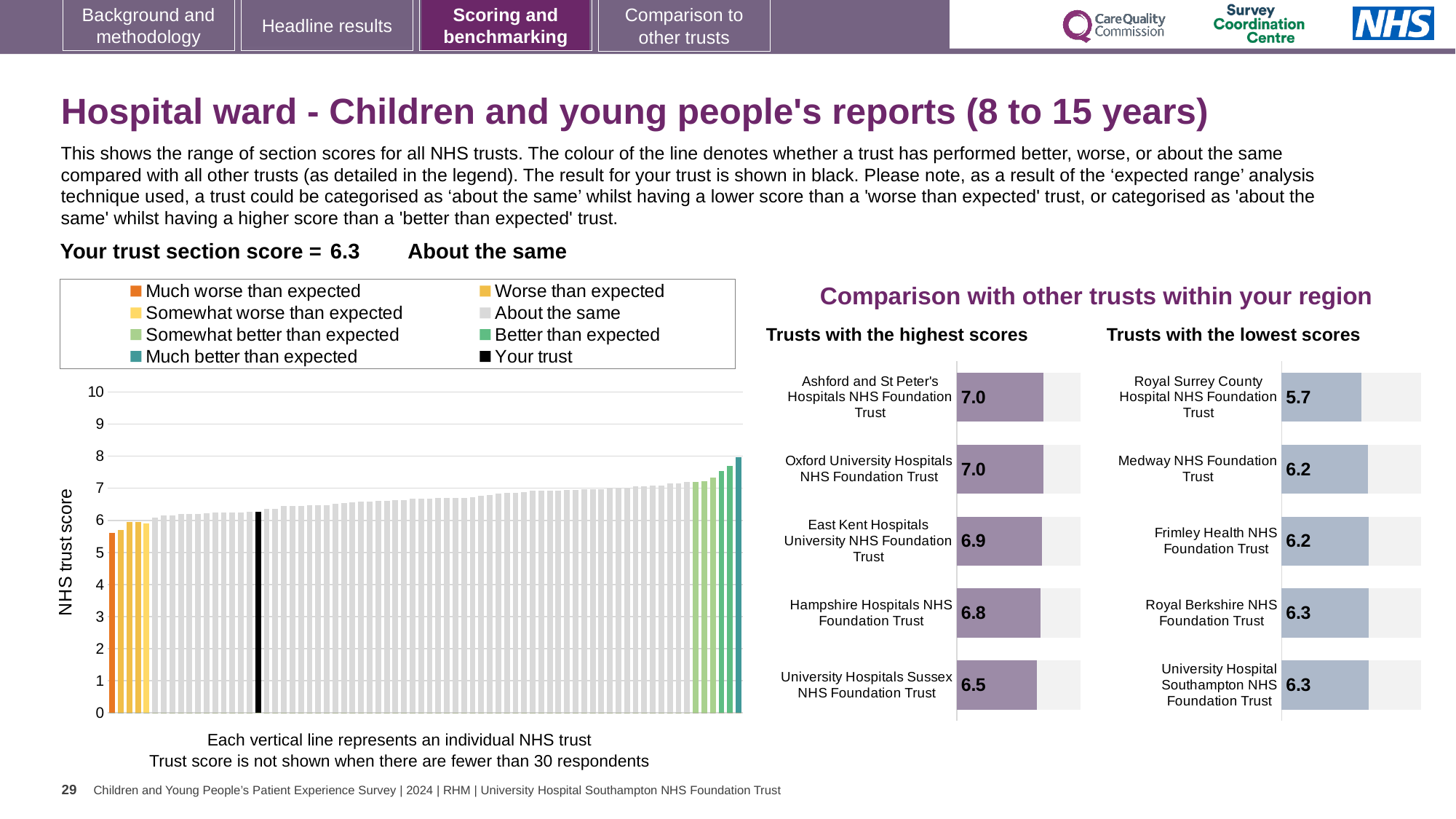
In the 'Trusts with the lowest scores' chart, what is the difference between the scores of Royal Berkshire NHS Foundation Trust and Royal Surrey County Hospital NHS Foundation Trust? 0.6 How many trusts are shown in the 'Trusts with the highest scores' chart? 5 How many entries does the legend above the main 'NHS trust score' chart list? 8 What kind of chart is the main 'NHS trust score' chart on the left? bar chart In the 'Trusts with the highest scores' chart, what is the score for East Kent Hospitals University NHS Foundation Trust? 6.9 Which has a higher score: Hampshire Hospitals NHS Foundation Trust in the 'highest scores' chart or Medway NHS Foundation Trust in the 'lowest scores' chart? Hampshire Hospitals NHS Foundation Trust In the 'Trusts with the lowest scores' chart, which trust has the lowest score? Royal Surrey County Hospital NHS Foundation Trust In the main 'NHS trust score' chart on the left, is the value for the black 'Your trust' bar greater or less than 7? less In the 'Trusts with the highest scores' chart, which trust has the lowest score? University Hospitals Sussex NHS Foundation Trust In the 'Trusts with the lowest scores' chart, what is the score for Royal Surrey County Hospital NHS Foundation Trust? 5.7 In the 'Trusts with the highest scores' chart, what is the difference between the scores of Ashford and St Peter's Hospitals NHS Foundation Trust and University Hospitals Sussex NHS Foundation Trust? 0.5 In the main 'NHS trust score' chart on the left, do the bar values rise or fall from left to right? rise